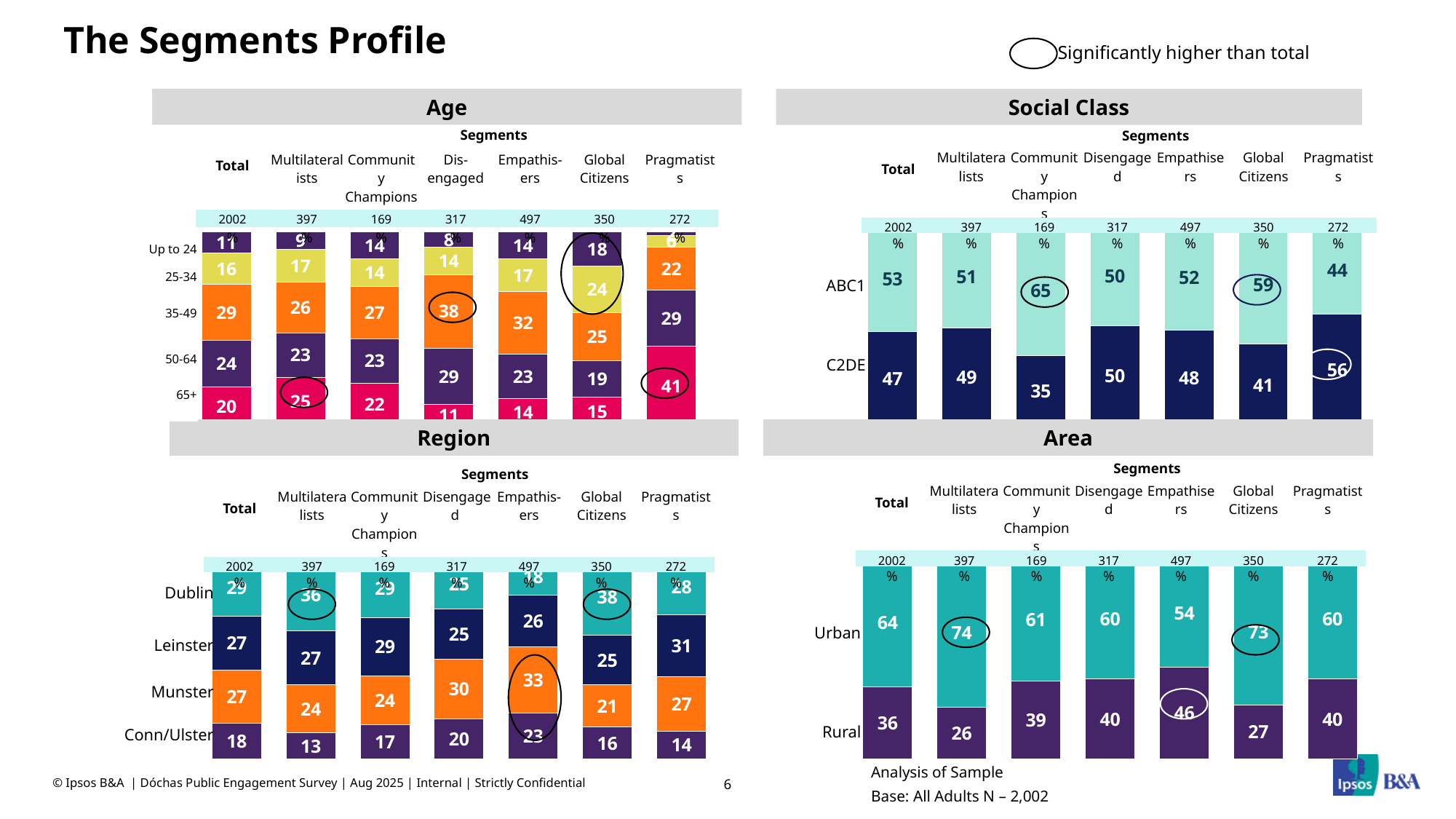
In the Area chart, what is the Urban value for Multilateralists? 74 In the Social Class chart, what is the ABC1 value for Community Champions? 65 In the Area chart, which segment has the highest Rural value? Empathisers In the Region chart, what is the Munster value for Empathisers? 33 In the Area chart, what is the difference between the Urban values for Global Citizens and Total? 9 In the Region chart, how many region categories are shown? 4 In the Region chart, which segment has the highest Dublin value? Global Citizens In the Social Class chart, which segment has the lowest C2DE value? Community Champions In the Age chart, what is the 35-49 value for Disengaged? 38 In the Age chart, what is the sample size shown for Global Citizens? 350 In the Social Class chart, which is larger for Pragmatists: ABC1 or C2DE? C2DE What type of chart is the Age chart? Stacked bar chart